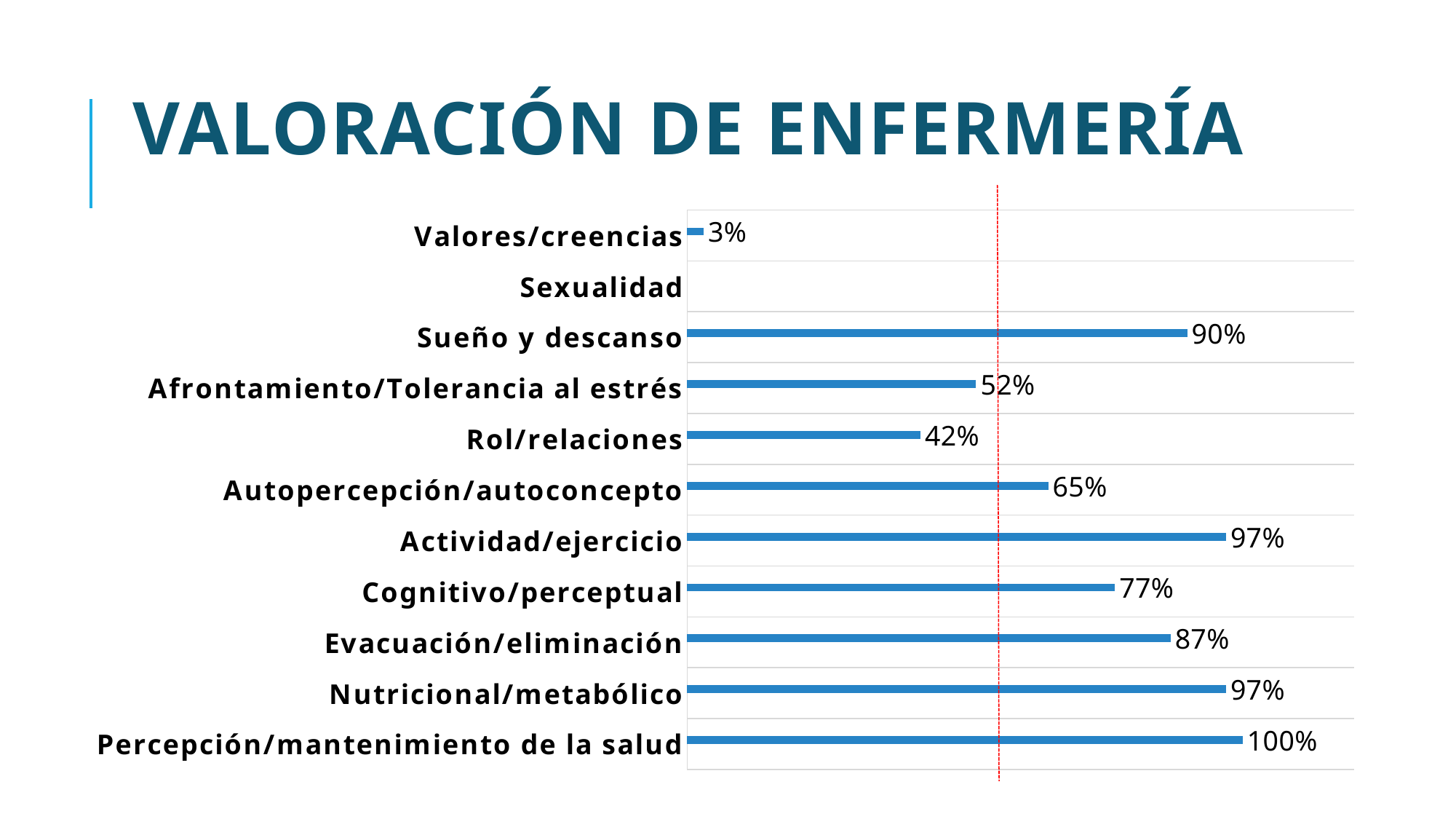
What kind of chart is shown on the slide? Bar chart How many categories are listed on the chart? 11 What is the value for Rol/relaciones? 42% What is the value for Sueño y descanso? 90% What is the difference between the values for Actividad/ejercicio and Autopercepción/autoconcepto? 32% What is the title of the slide? VALORACIÓN DE ENFERMERÍA Which is larger, the value for Cognitivo/perceptual or the value for Autopercepción/autoconcepto? Cognitivo/perceptual What is the value for Cognitivo/perceptual? 77% Which category has the highest value? Percepción/mantenimiento de la salud What is the difference between the values for Evacuación/eliminación and Afrontamiento/Tolerancia al estrés? 35% What is the value for Valores/creencias? 3% Which category has the lowest printed value? Valores/creencias